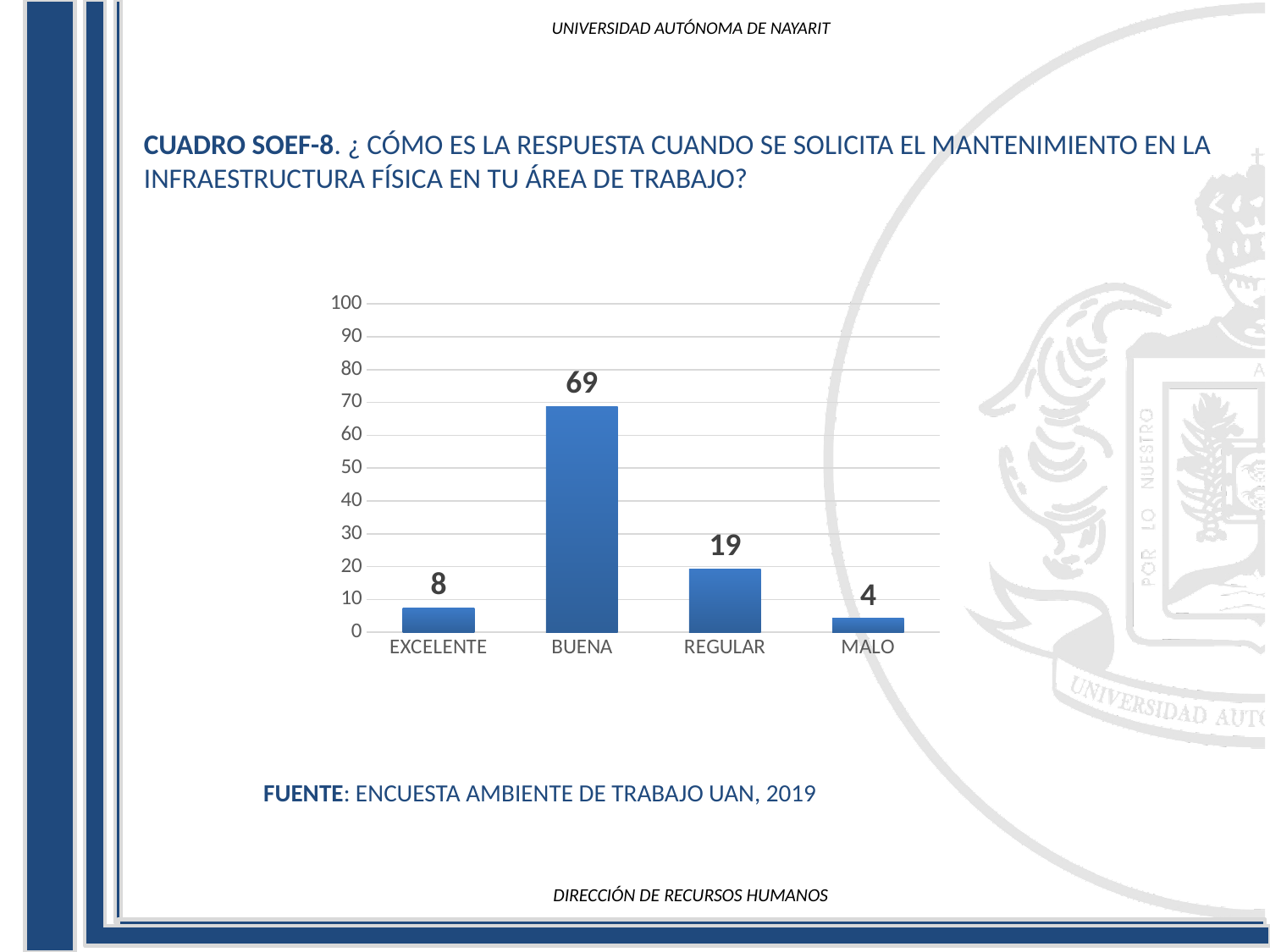
What is the value for EXCELENTE? 8 Which category has the lowest value? MALO What is the source cited below the chart? ENCUESTA AMBIENTE DE TRABAJO UAN, 2019 How many categories are shown on the x axis? 4 Which is larger, the value for EXCELENTE or the value for REGULAR? REGULAR Is the value for BUENA greater or less than 60? greater What is the value for BUENA? 69 What kind of chart is shown on the slide? bar chart Which category has the highest value? BUENA What is the value for MALO? 4 What is the value for REGULAR? 19 What is the difference between the values for BUENA and REGULAR? 50